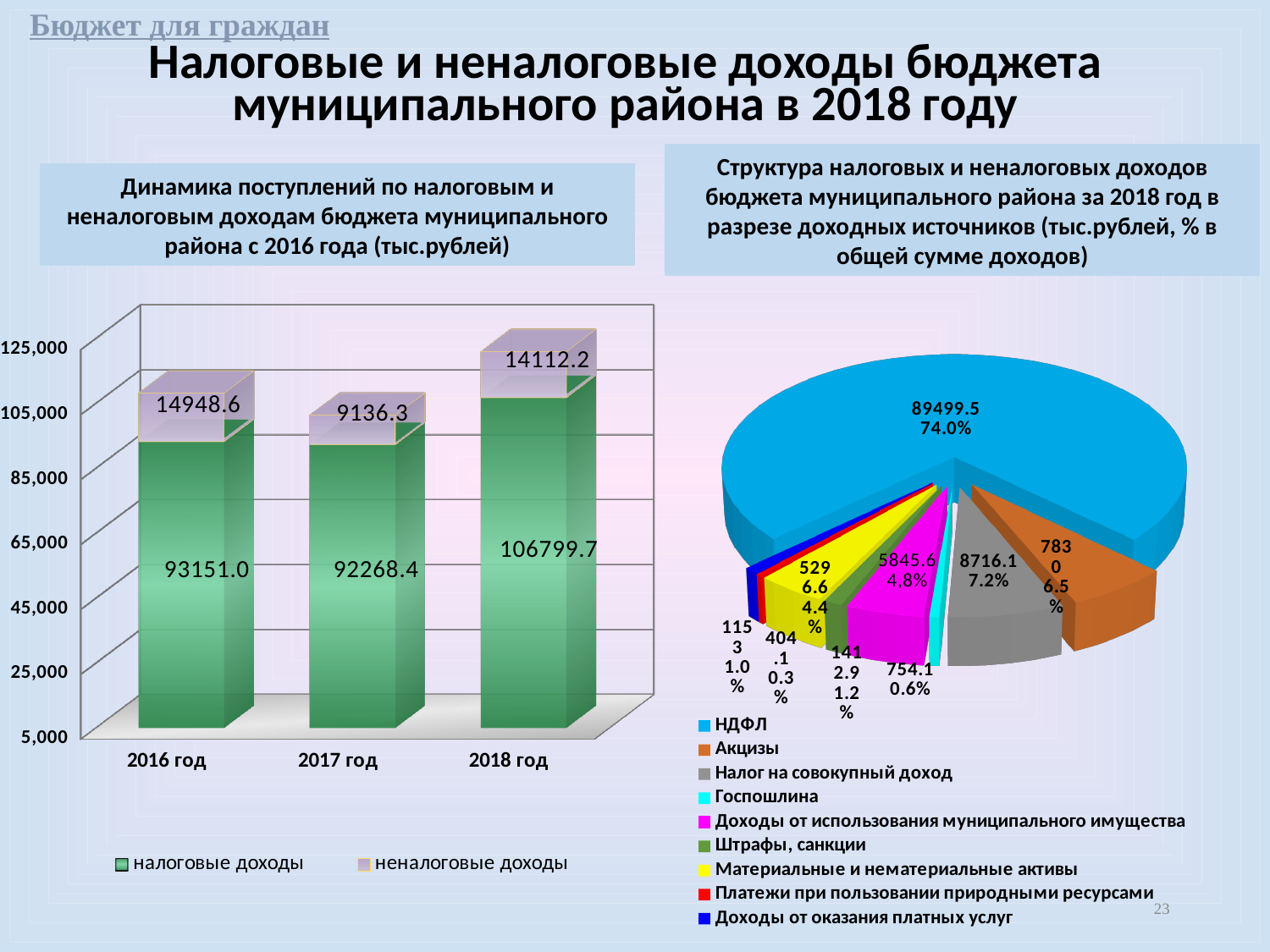
On the left chart (Динамика поступлений), what is the difference between налоговые доходы in 2018 год and 2017 год? 14531.3 On the right pie chart (Структура налоговых и неналоговых доходов), what is the value in тыс.рублей for НДФЛ? 89499.5 What kind of chart is the left chart (Динамика поступлений)? Stacked bar chart On the left chart (Динамика поступлений), how many series does the legend list? 2 On the left chart (Динамика поступлений), what is the value of неналоговые доходы for 2017 год? 9136.3 On the right pie chart (Структура налоговых и неналоговых доходов), how many income sources does the legend list? 9 On the left chart (Динамика поступлений), which year has the lowest неналоговые доходы? 2017 год On the left chart (Динамика поступлений), what is the value of неналоговые доходы for 2016 год? 14948.6 On the left chart (Динамика поступлений), what is the value of налоговые доходы for 2018 год? 106799.7 On the left chart (Динамика поступлений), which year has the highest налоговые доходы? 2018 год On the left chart (Динамика поступлений), what is the total of the stacked bar for 2016 год? 108099.6 On the right pie chart (Структура налоговых и неналоговых доходов), what share of total income does НДФЛ account for? 74.0%